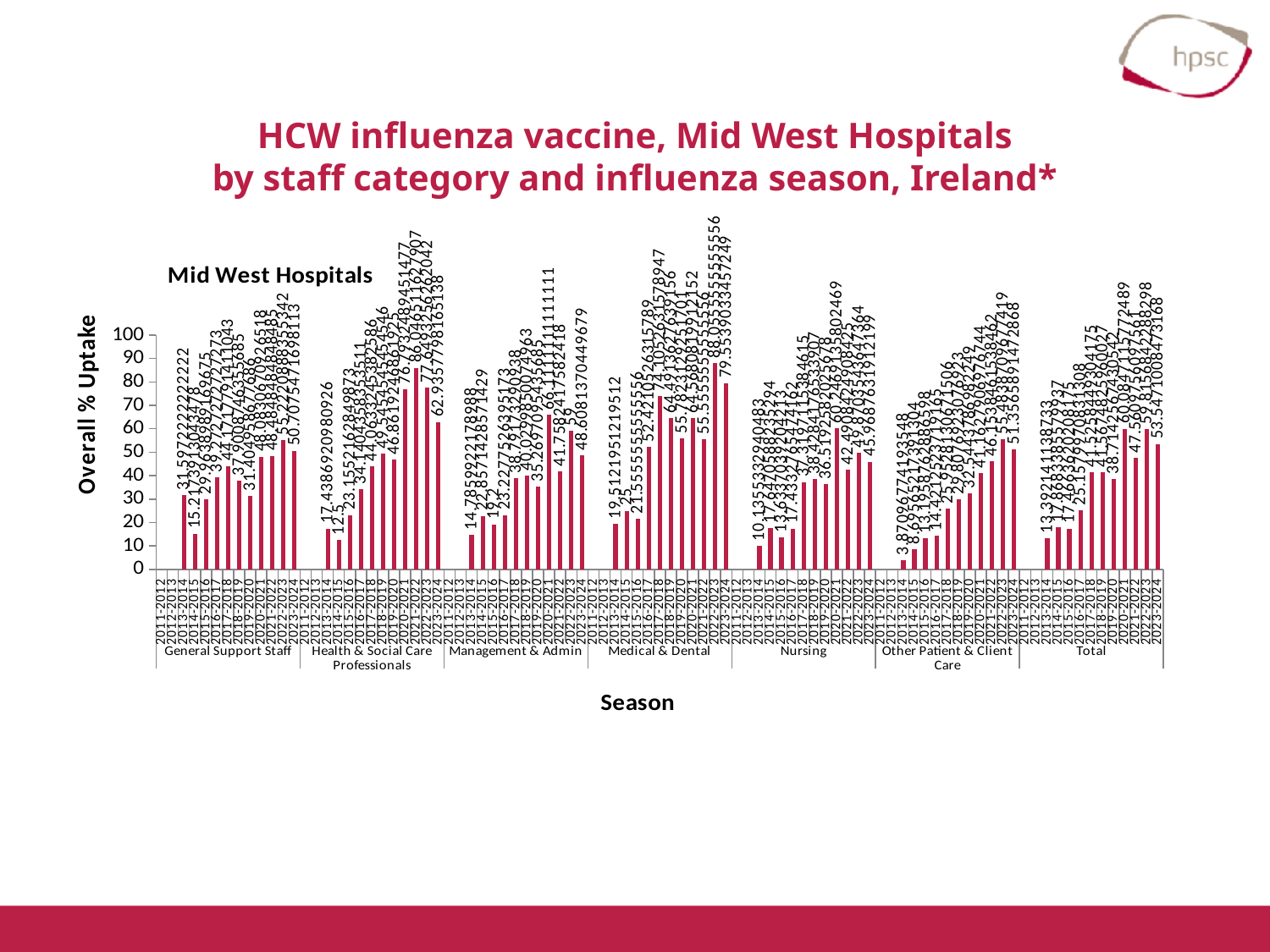
What is the value for Management & Admin in the 2023-2024 season? 48.6081370449679 What is the label on the vertical axis of the chart? Overall % Uptake Is the value for Medical & Dental in the 2023-2024 season greater or less than 70? greater What is the label on the horizontal axis of the chart? Season What kind of chart is shown on the slide? Bar chart What is the value for Health & Social Care Professionals in the 2014-2015 season? 12.5 How many staff categories are shown along the x axis of the chart? 7 Which staff category contains the lowest bar on the chart? Other Patient & Client Care Which staff category contains the highest bar on the chart? Medical & Dental Is the value for Nursing in the 2023-2024 season greater or less than 50? less What is the value for Health & Social Care Professionals in the 2023-2024 season? 62.9357798165138 Which is larger in the 2023-2024 season, the value for Medical & Dental or the value for Nursing? Medical & Dental